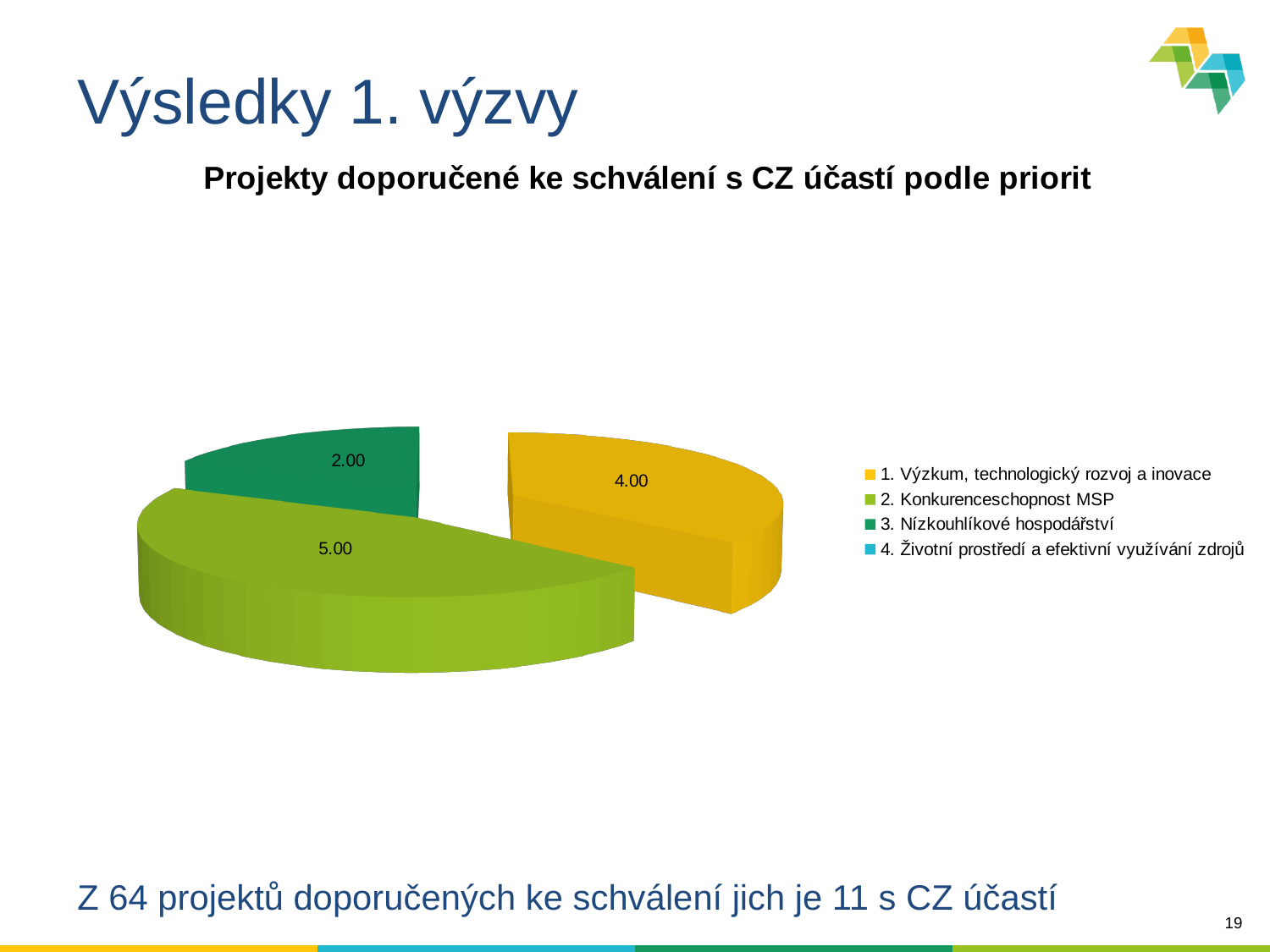
What type of chart is shown on the slide? pie chart What is the value of the slice for 1. Výzkum, technologický rozvoj a inovace? 4.00 What is the title of the pie chart? Projekty doporučené ke schválení s CZ účastí podle priorit What is the value of the slice for 3. Nízkouhlíkové hospodářství? 2.00 Which is larger: the slice for 1. Výzkum, technologický rozvoj a inovace or the slice for 3. Nízkouhlíkové hospodářství? 1. Výzkum, technologický rozvoj a inovace What is the value of the slice for 2. Konkurenceschopnost MSP? 5.00 Which category with a visible slice has the smallest value? 3. Nízkouhlíkové hospodářství How many slices with data labels are shown in the pie chart? 3 What is the difference between the values for 2. Konkurenceschopnost MSP and 3. Nízkouhlíkové hospodářství? 3.00 Which category has the largest slice in the pie chart? 2. Konkurenceschopnost MSP How many entries does the legend of the pie chart list? 4 What is the total of the values labelled on the pie chart? 11.00